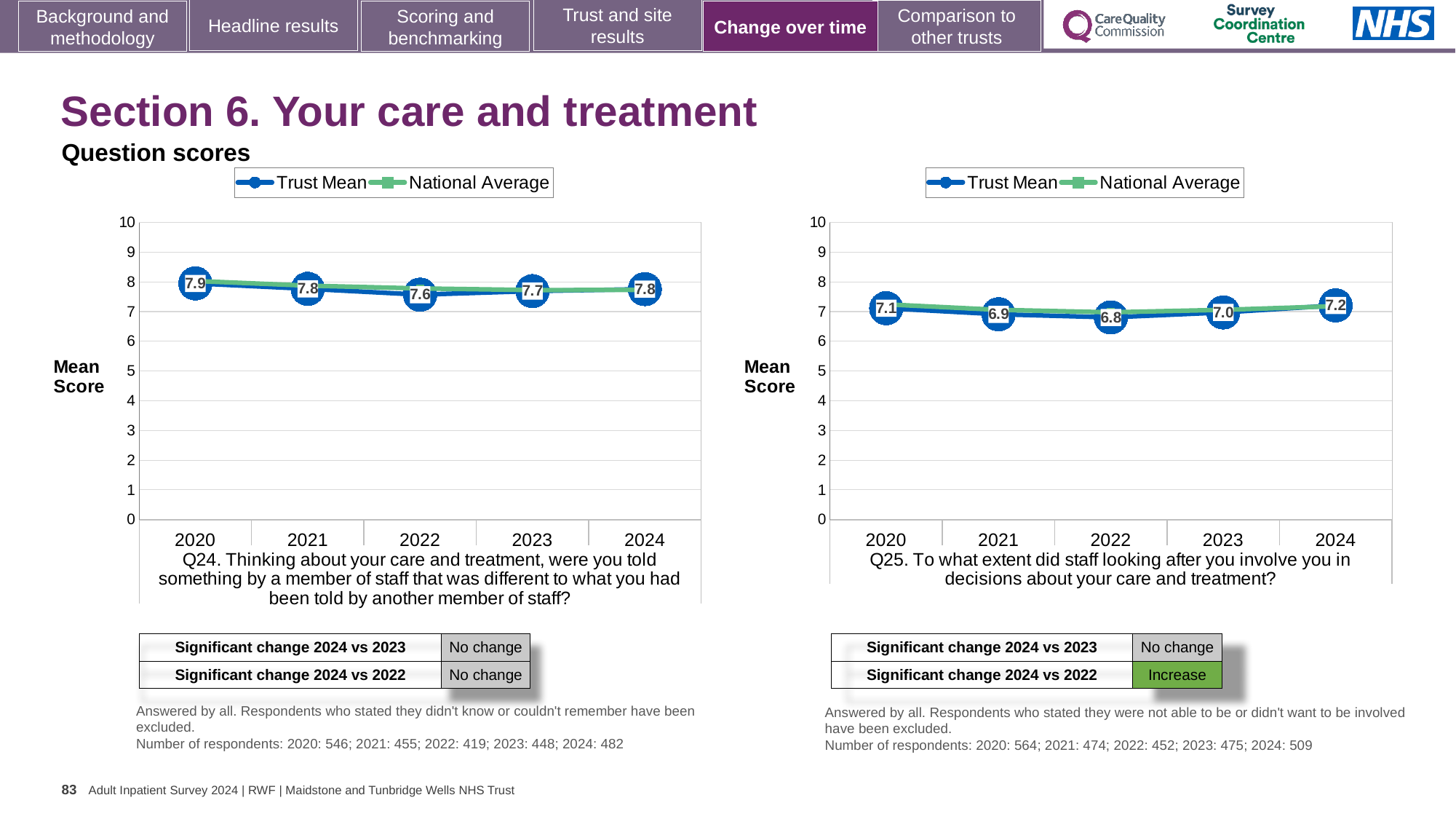
On the Q24 chart (left), is the Trust Mean score for 2021 larger than the Trust Mean score for 2023? Yes On the Q25 chart (right), which year has the lowest Trust Mean score? 2022 On the Q25 chart (right), which year has the highest Trust Mean score? 2024 On the Q25 chart (right), what is the Trust Mean score for 2021? 6.9 How many series does the legend of the Q25 chart (right) list? 2 On the Q24 chart (left), what is the difference between the Trust Mean scores for 2020 and 2022? 0.3 On the Q25 chart (right), what is the Trust Mean score for 2024? 7.2 On the Q24 chart (left), which year has the lowest Trust Mean score? 2022 On the Q25 chart (right), what is the difference between the Trust Mean scores for 2024 and 2022? 0.4 On the Q24 chart (left), what is the Trust Mean score for 2020? 7.9 What kind of chart is the Q24 chart (left)? Line chart On the Q24 chart (left), what is the Trust Mean score for 2022? 7.6